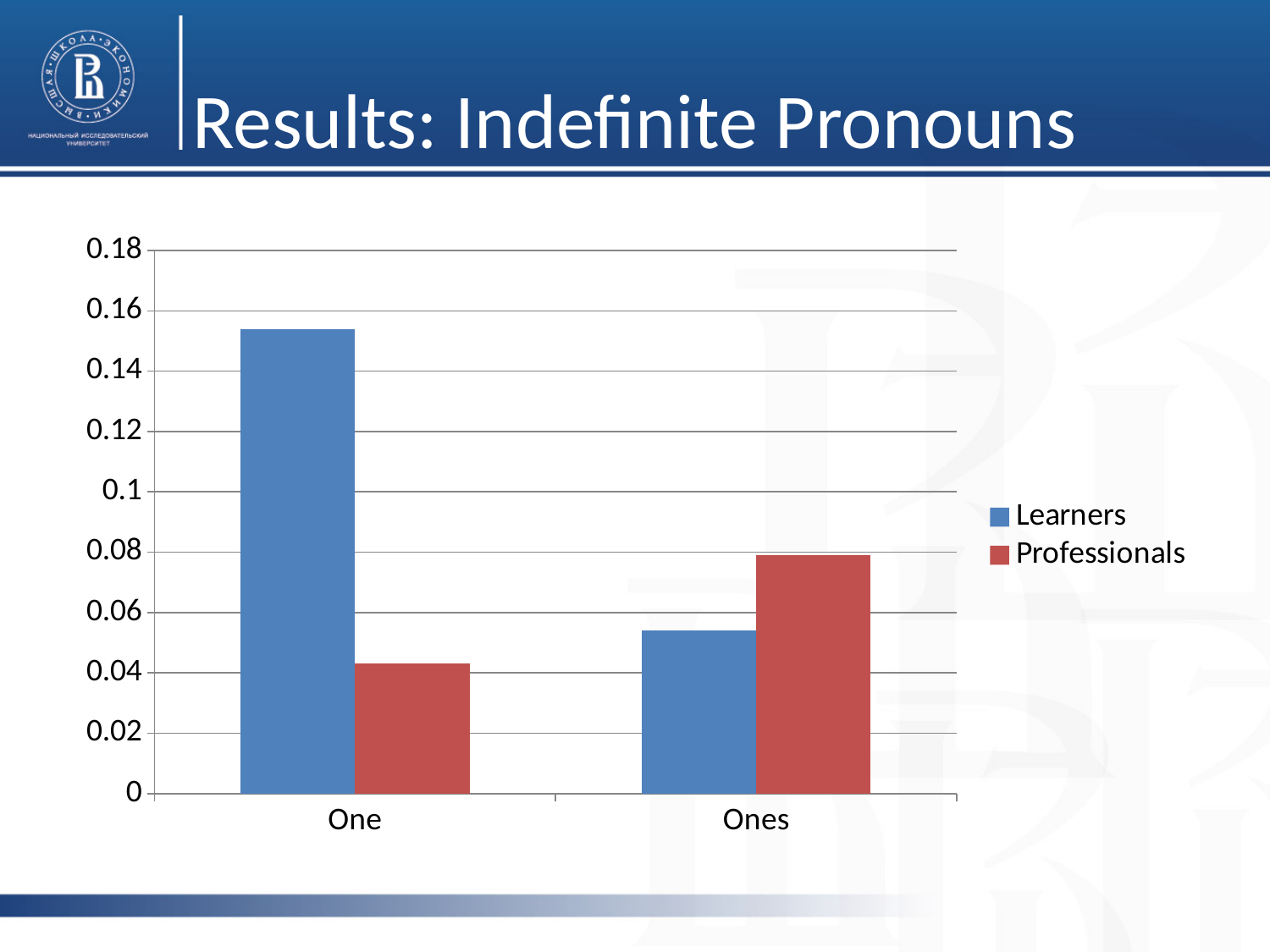
What is the title of the slide containing the chart? Results: Indefinite Pronouns Is the value for Learners in the One category greater or less than 0.14? greater Is the value for Learners in the Ones category greater or less than 0.08? less Is the value for Professionals in the Ones category greater or less than 0.06? greater How many series does the legend list? 2 Which is larger for the Ones category, Learners or Professionals? Professionals Which is larger for the One category, Learners or Professionals? Learners Which series does the blue bar represent? Learners Which bar is the highest in the chart? Learners, One How many categories are shown on the x axis? 2 What kind of chart is shown on the slide? bar chart